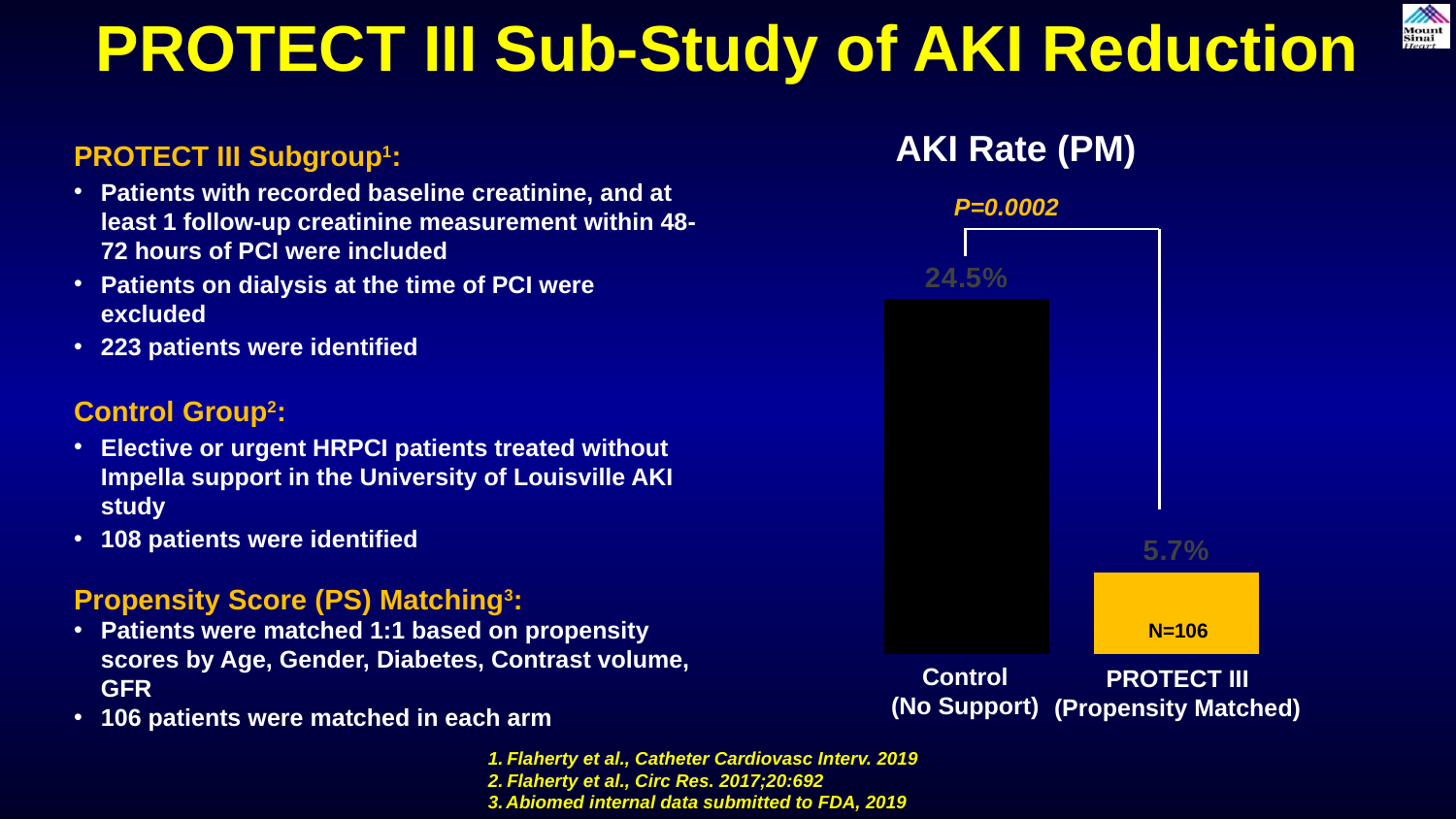
What is the AKI rate for the Control (No Support) group? 24.5% Is the AKI rate larger for Control (No Support) or for PROTECT III (Propensity Matched)? Control (No Support) What p-value is shown above the bars in the chart? P=0.0002 What is the AKI rate for the PROTECT III (Propensity Matched) group? 5.7% What is the difference in AKI rate between the Control (No Support) group and the PROTECT III (Propensity Matched) group? 18.8% What sample size (N) is printed on the PROTECT III (Propensity Matched) bar? N=106 Which group has the higher AKI rate? Control (No Support) Which group has the lower AKI rate? PROTECT III (Propensity Matched) What is the title of the chart? AKI Rate (PM) How many groups are plotted in the AKI Rate (PM) chart? 2 What kind of chart is used to show the AKI rates? Bar chart